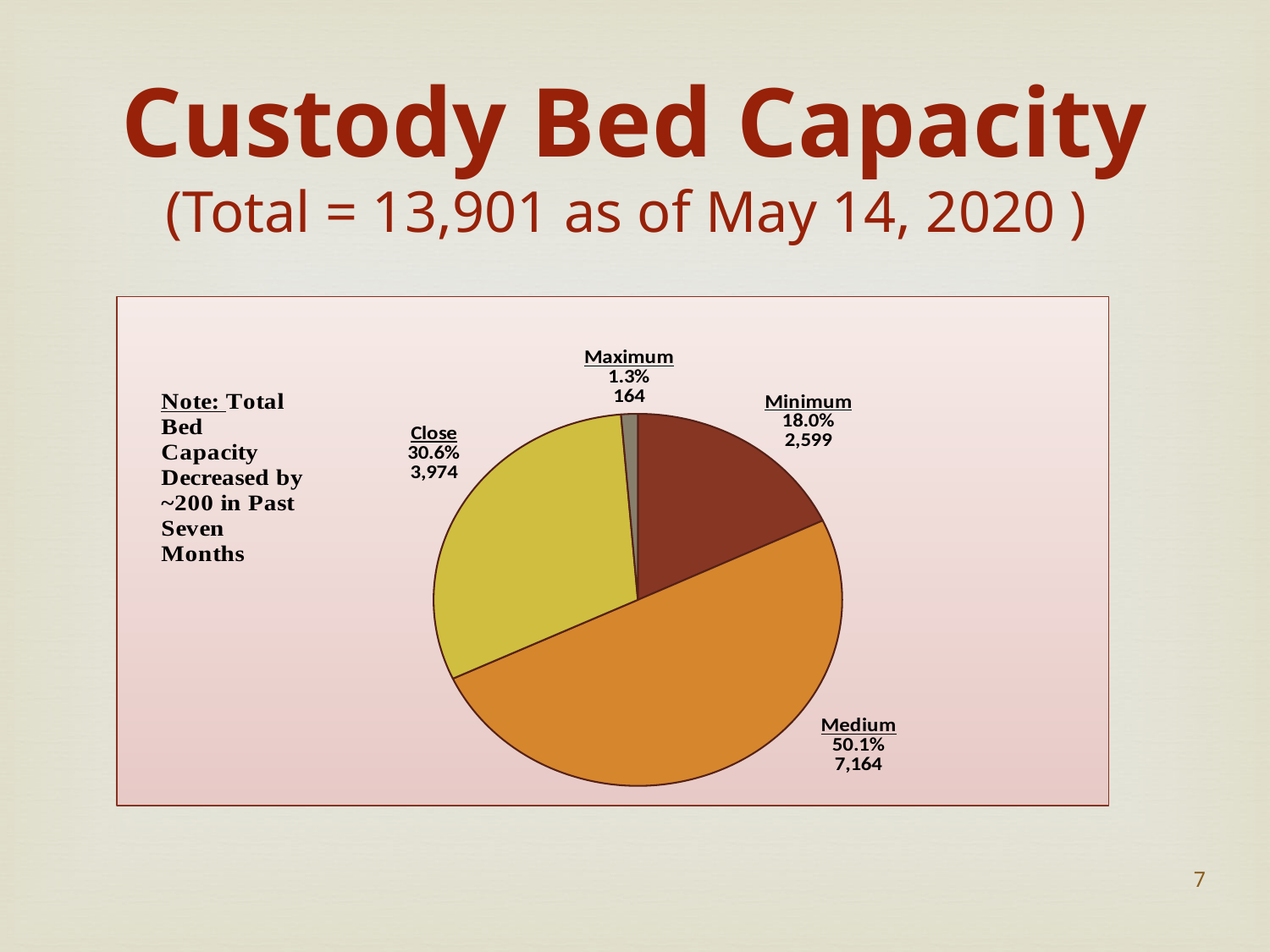
What kind of chart is shown on the slide? pie chart What share of the pie does Minimum represent? 18.0% What is the bed capacity value for Maximum? 164 Which is larger, the Close value or the Minimum value? Close What is the bed capacity value for Medium? 7,164 How many slices does the pie chart have? 4 Which category has the largest slice? Medium What is the bed capacity value for Minimum? 2,599 Which category has the smallest slice? Maximum What is the difference between the Medium and Close bed capacity values? 3,190 What share of the pie does Close represent? 30.6% What is the bed capacity value for Close? 3,974